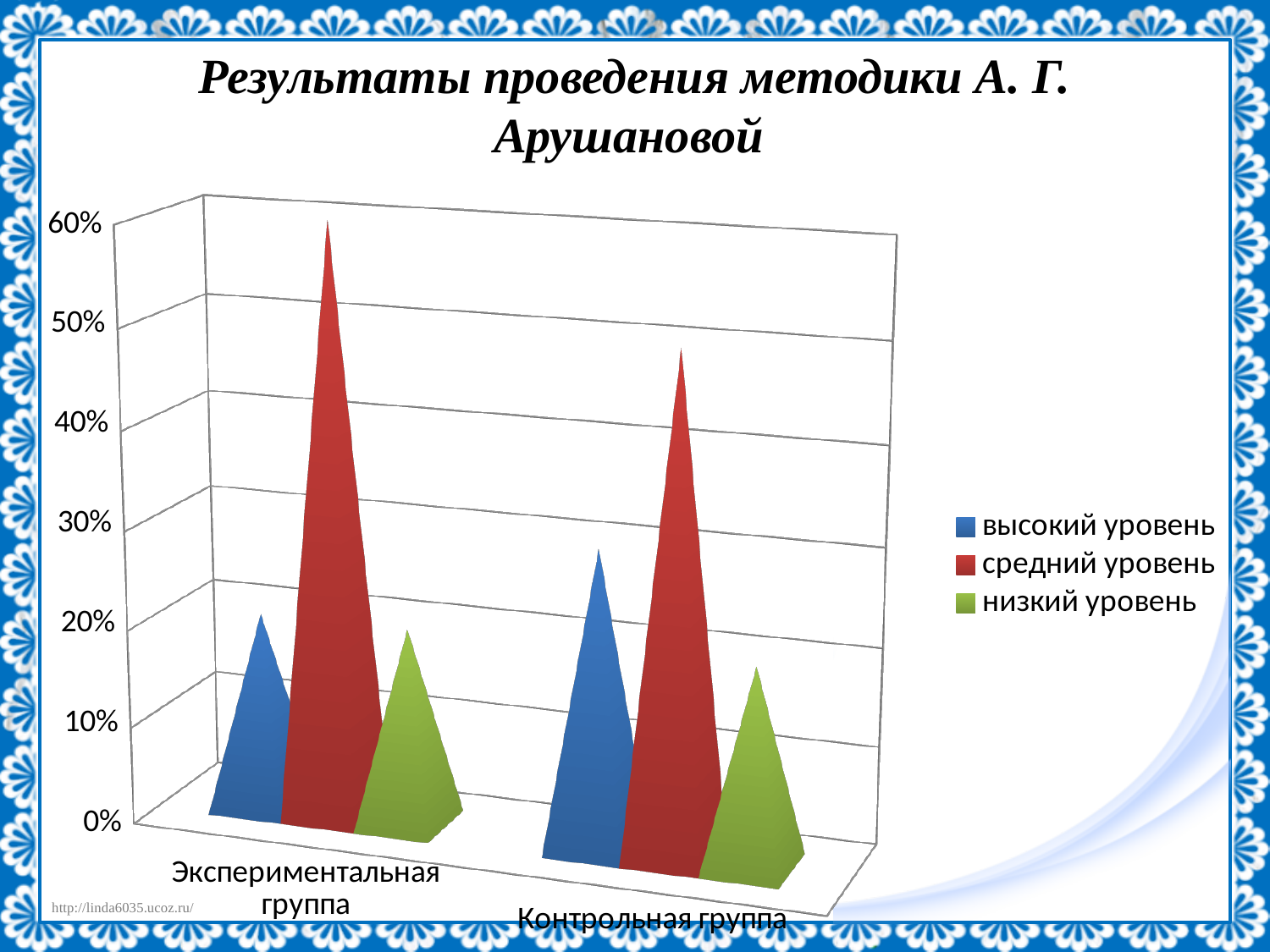
Is the value for средний уровень in the Экспериментальная группа greater or less than 50%? greater Is the value for высокий уровень in the Экспериментальная группа greater or less than 30%? less Which level has the highest value in the Контрольная группа? средний уровень Which group has the larger value for средний уровень, Экспериментальная группа or Контрольная группа? Экспериментальная группа Which level has the lowest value in the Контрольная группа? низкий уровень Is the value for средний уровень in the Контрольная группа greater or less than 40%? greater How many groups (categories) are shown on the x axis? 2 What is the title of the chart? Результаты проведения методики А. Г. Арушановой What kind of chart is shown on the slide? bar chart How many series does the legend list? 3 Which series is shown in red in the legend? средний уровень Which level has the highest value in the Экспериментальная группа? средний уровень